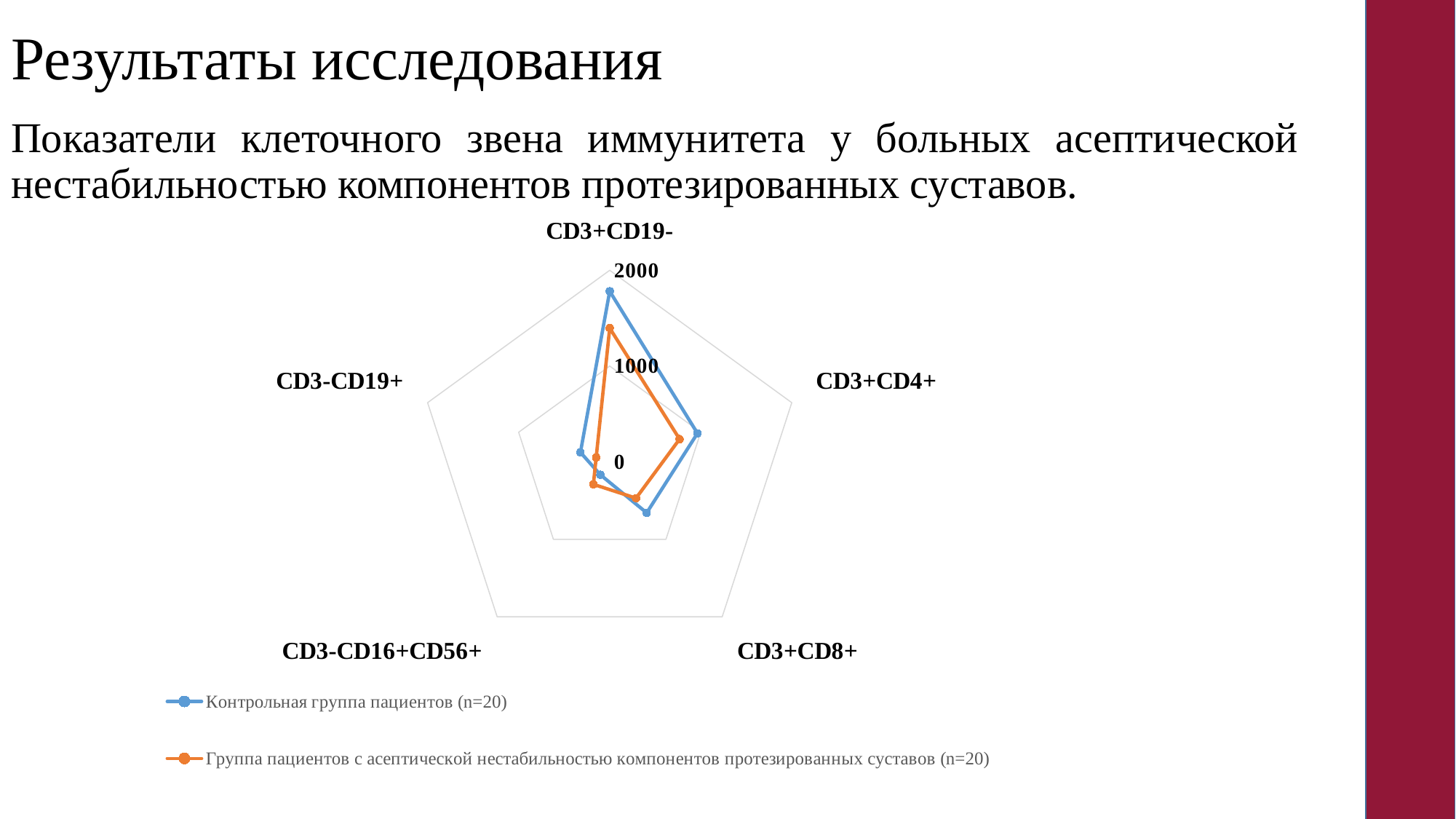
How many categories (axes) does the radar chart have? 5 Is the control group's value for CD3+CD8+ greater or less than 1000? less Is the aseptic instability group's value for CD3-CD19+ greater or less than 1000? less What kind of chart is shown on the slide? Radar chart For the control group, which category has the lowest value? CD3-CD16+CD56+ For CD3+CD19-, which group has the larger value: the control group or the aseptic instability group? Control group Is the aseptic instability group's value for CD3+CD19- greater or less than 1000? greater For the group with aseptic instability (Группа пациентов с асептической нестабильностью), which category has the highest value? CD3+CD19- What is the maximum value shown on the radar chart's axis scale? 2000 For the control group (Контрольная группа пациентов), which category has the highest value? CD3+CD19- How many series does the legend list? 2